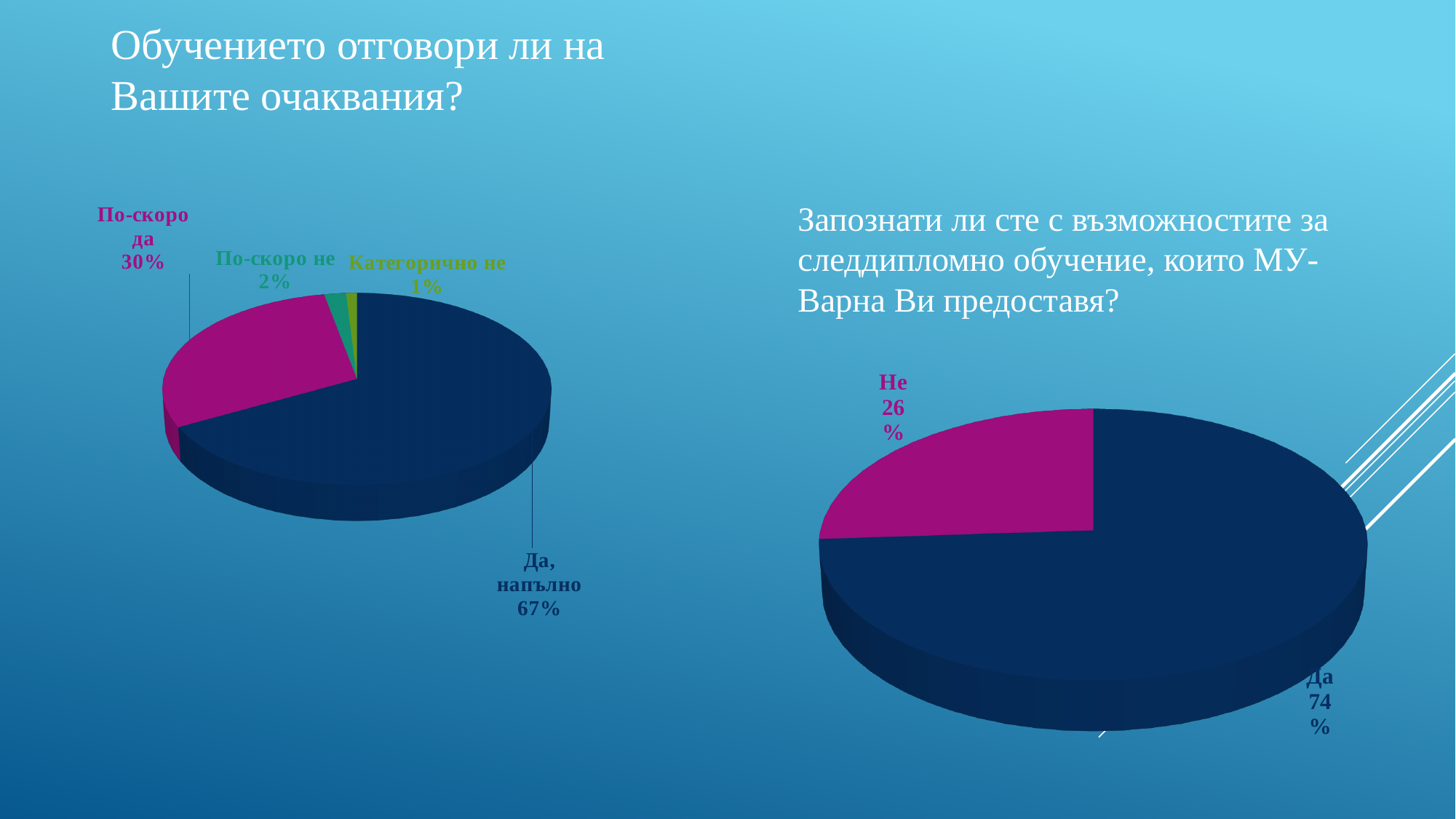
In the left chart (Обучението отговори ли на Вашите очаквания?), which category has the smallest slice? Категорично не In the left chart (Обучението отговори ли на Вашите очаквания?), what share is labelled for 'Да, напълно'? 67% In the right chart (Запознати ли сте с възможностите за следдипломно обучение...), what share is labelled for 'Да'? 74% In the right chart (Запознати ли сте с възможностите за следдипломно обучение...), what share is labelled for 'Не'? 26% In the left chart (Обучението отговори ли на Вашите очаквания?), how many slices does the pie have? 4 In the left chart (Обучението отговори ли на Вашите очаквания?), what share is labelled for 'По-скоро да'? 30% In the left chart (Обучението отговори ли на Вашите очаквания?), which category has the largest slice? Да, напълно In the right chart (Запознати ли сте с възможностите за следдипломно обучение...), which is larger, 'Да' or 'Не'? Да In the right chart (Запознати ли сте с възможностите за следдипломно обучение...), what is the difference between 'Да' and 'Не'? 48% In the left chart (Обучението отговори ли на Вашите очаквания?), what is the difference between 'Да, напълно' and 'По-скоро да'? 37% What kind of chart is the right chart (Запознати ли сте с възможностите за следдипломно обучение...)? Pie chart In the left chart (Обучението отговори ли на Вашите очаквания?), what share is labelled for 'Категорично не'? 1%